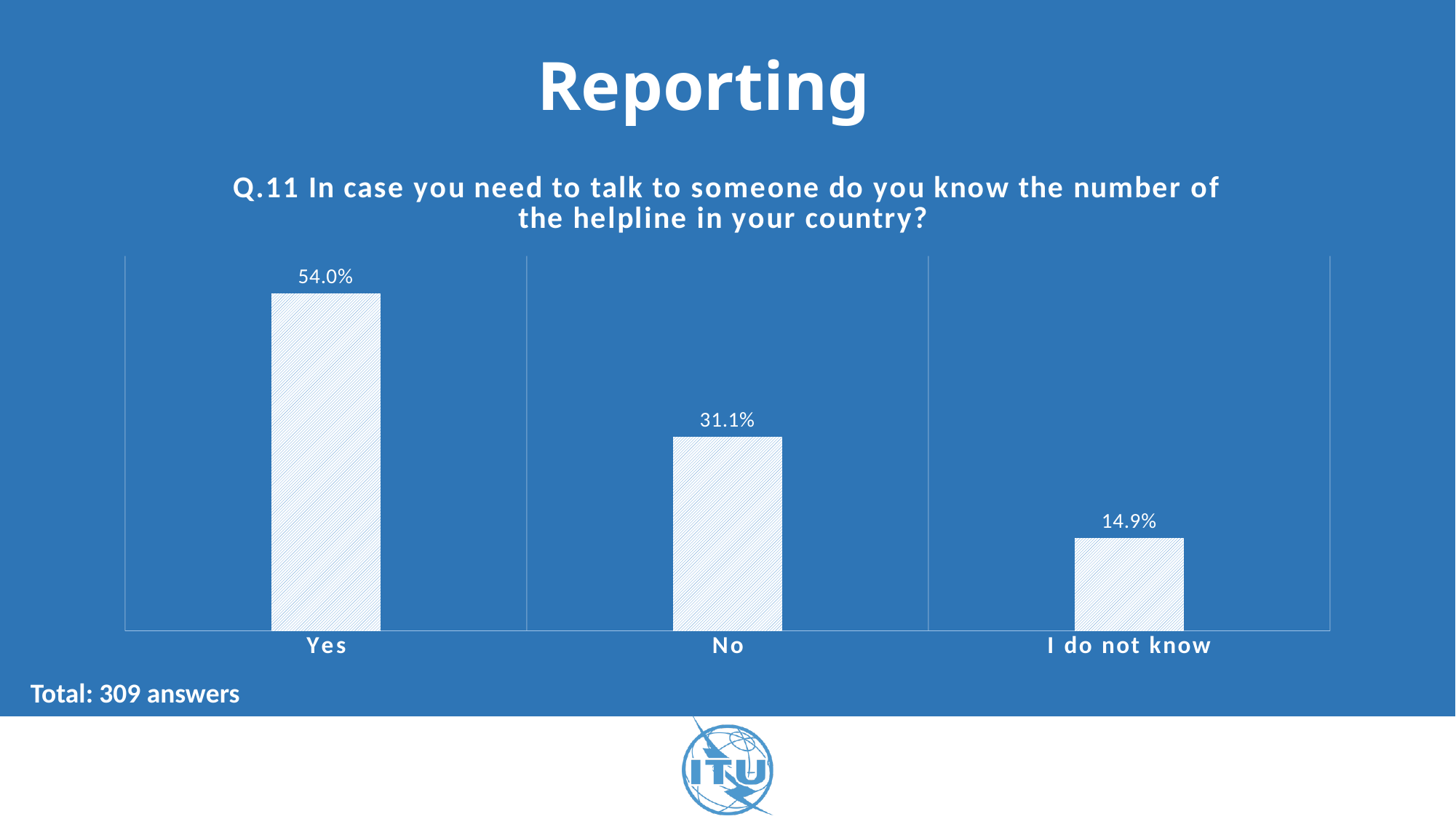
What is the difference in percentage points between "No" and "I do not know"? 16.2 How many answer categories are shown in the chart? 3 Which is larger, the percentage for "No" or for "I do not know"? No What percentage of respondents answered "Yes"? 54.0% Which answer category has the lowest percentage? I do not know What percentage of respondents answered "No"? 31.1% What percentage of respondents answered "I do not know"? 14.9% What is the difference in percentage points between "Yes" and "No"? 22.9 How many total answers does the slide report for this question? 309 answers Do the values rise or fall from left to right across the categories? Fall What type of chart is shown on the slide? Bar chart Which answer category has the highest percentage? Yes